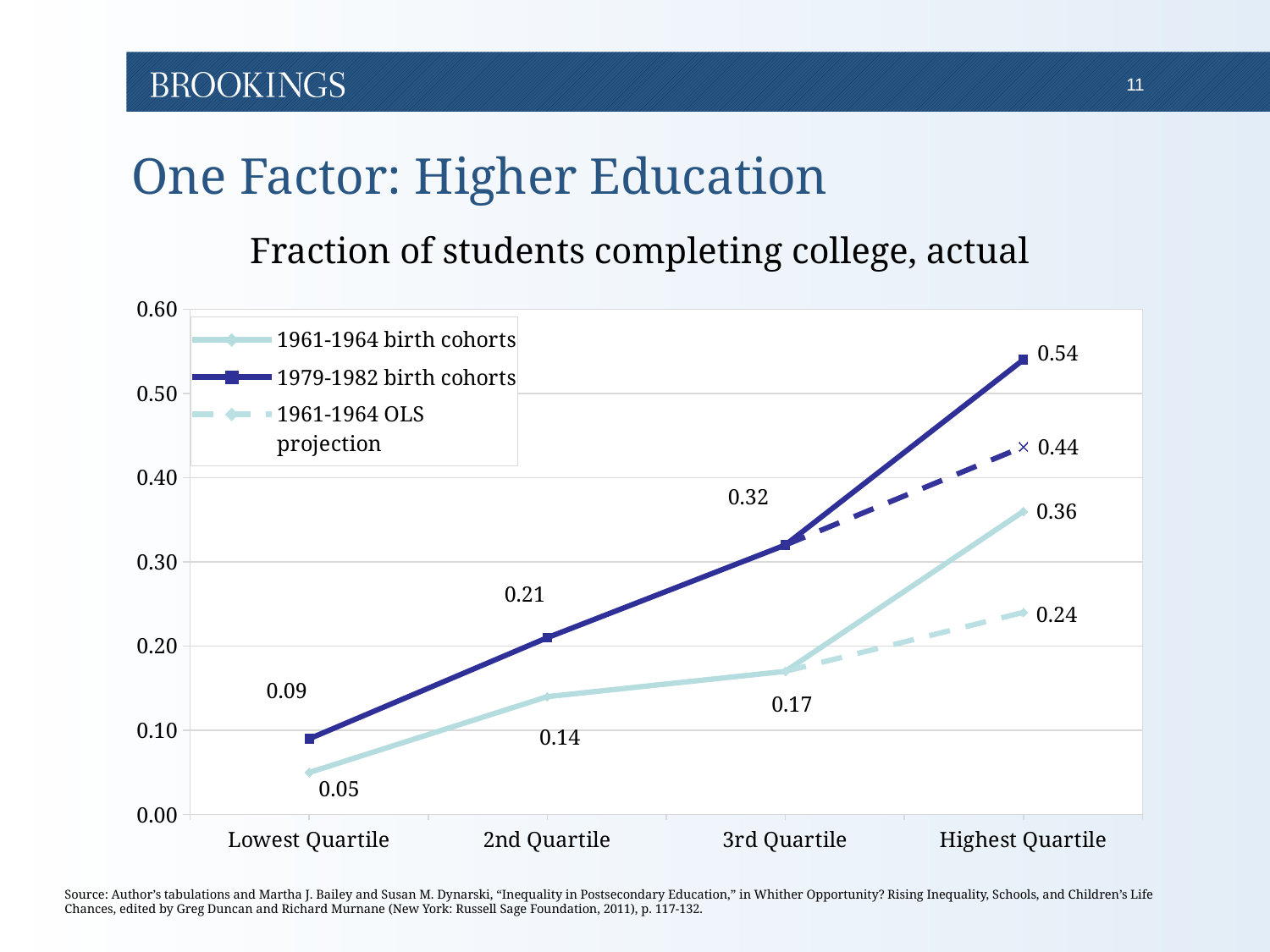
In the 2nd Quartile, which is larger: the 1979-1982 birth cohorts or the 1961-1964 birth cohorts? 1979-1982 birth cohorts What is the difference between the 1979-1982 and 1961-1964 birth cohorts in the 3rd Quartile? 0.15 How many series does the legend list? 3 What is the value for the 1979-1982 birth cohorts in the 2nd Quartile? 0.21 How many quartile categories are shown on the x axis? 4 Which quartile has the highest value for the 1961-1964 birth cohorts? Highest Quartile What is the value for the 1961-1964 OLS projection in the Highest Quartile? 0.24 Do the values for the 1979-1982 birth cohorts rise or fall from the Lowest Quartile to the Highest Quartile? rise What is the value for the 1961-1964 birth cohorts in the Lowest Quartile? 0.05 What is the value for the 1979-1982 birth cohorts in the Highest Quartile? 0.54 Which quartile has the lowest value for the 1979-1982 birth cohorts? Lowest Quartile What kind of chart is shown on the slide? line chart